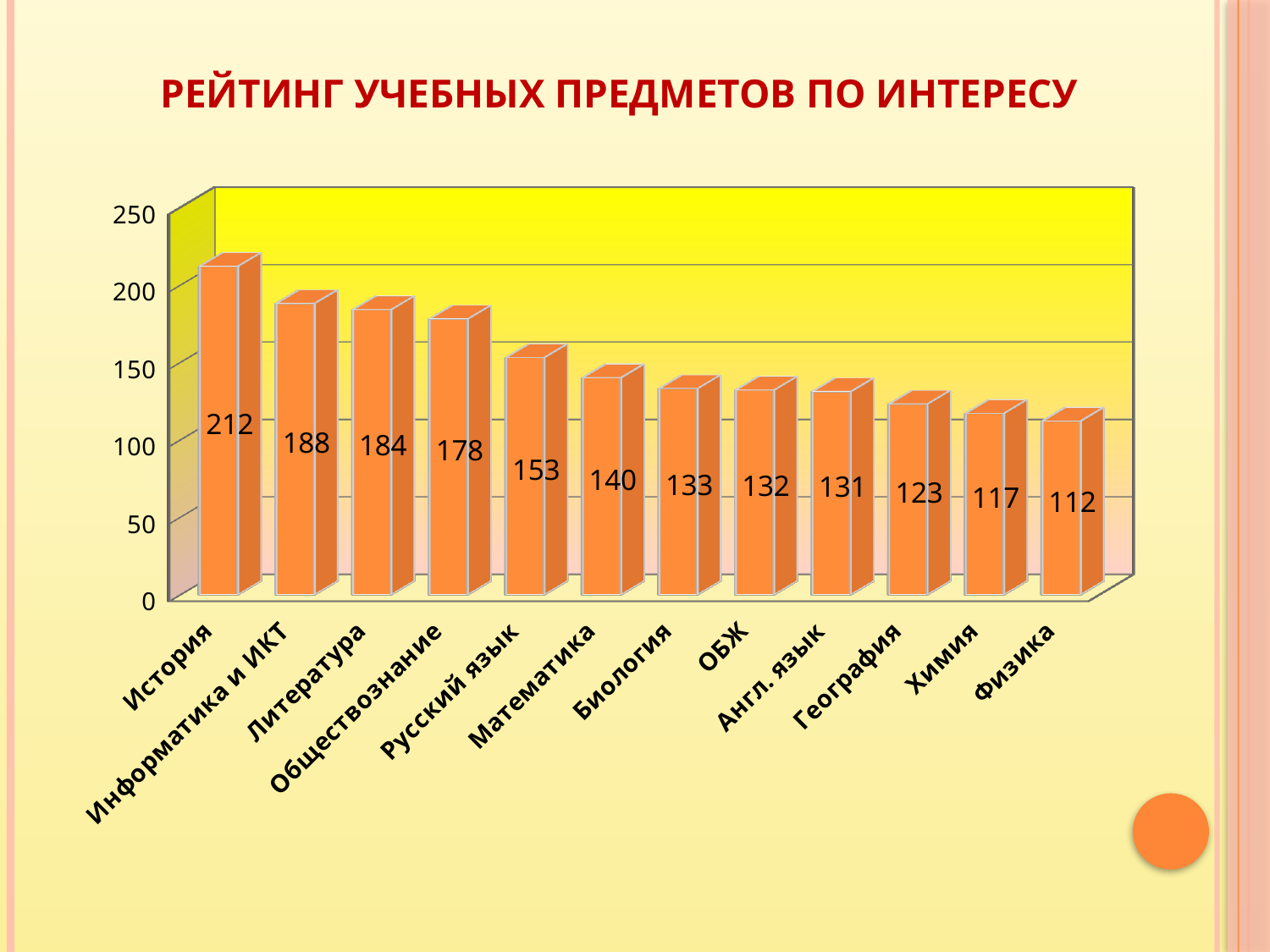
Which is larger, the value for Математика or the value for Химия? Математика What is the value for География? 123 Is the value for Обществознание greater or less than 150? greater What is the difference between the values for История and Физика? 100 What is the value for История? 212 How many subjects are shown in the chart? 12 Which subject has the highest value? История What is the value for Русский язык? 153 Which subject has the lowest value? Физика What is the difference between the values for Информатика и ИКТ and Литература? 4 What kind of chart is shown on the slide? bar chart What is the title of the chart? Рейтинг учебных предметов по интересу